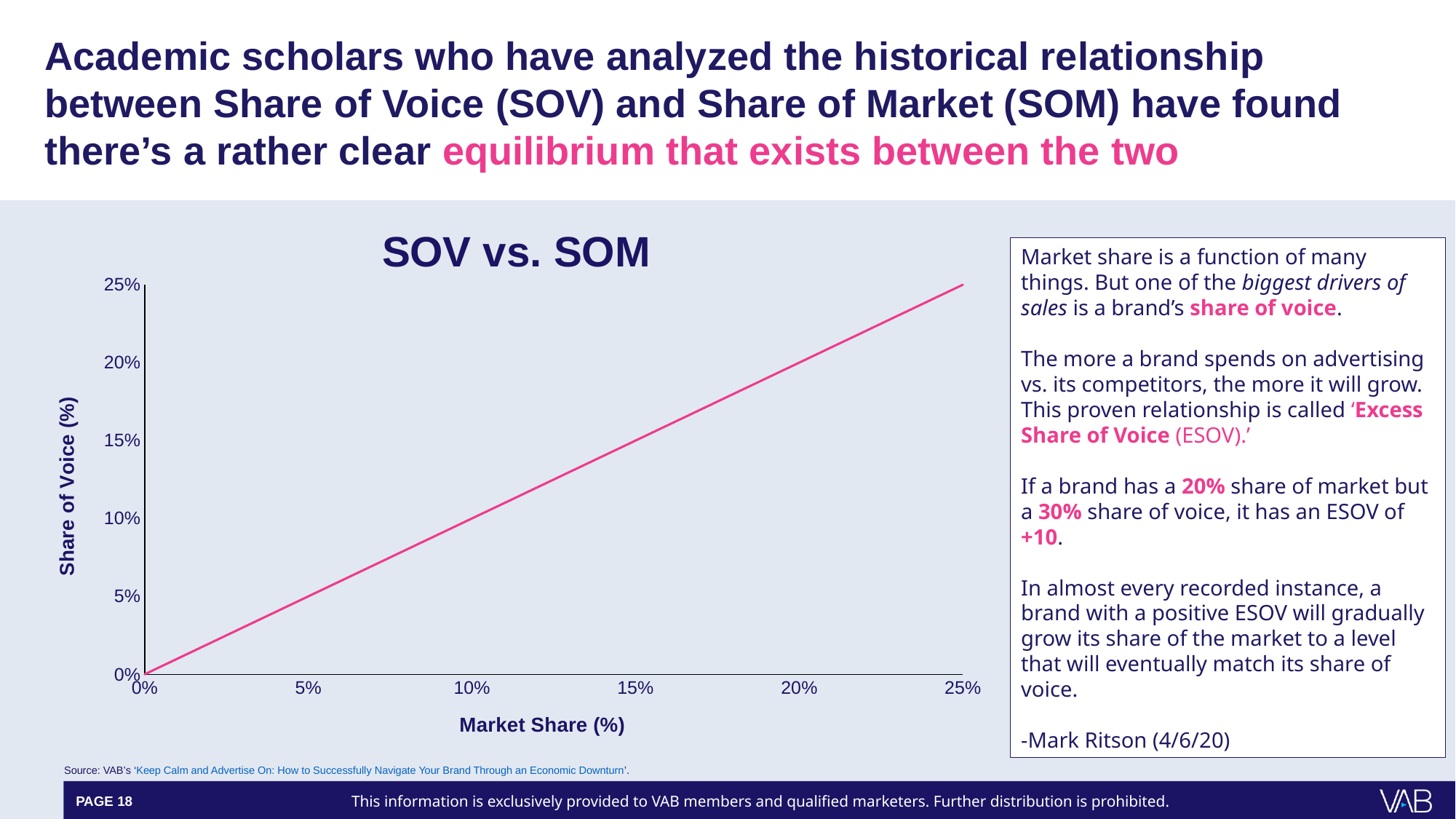
What is the title of the chart? SOV vs. SOM What is the label of the vertical axis of the chart? Share of Voice (%) Is the Share of Voice value at a Market Share of 20% greater or less than 15%? greater What kind of chart is shown on the slide? line chart What Share of Voice value does the line start at when Market Share is 0%? 0% Is the Share of Voice value at a Market Share of 5% greater or less than 10%? less Which is larger: the Share of Voice at a Market Share of 25% or at a Market Share of 5%? at 25% What Share of Voice value does the line reach at a Market Share of 25%? 25% How many tick labels are shown on the Share of Voice axis? 6 Does the line in the chart rise or fall as Market Share increases? rises What is the highest value shown on the Market Share axis? 25% Is the Share of Voice value at a Market Share of 15% greater or less than 20%? less